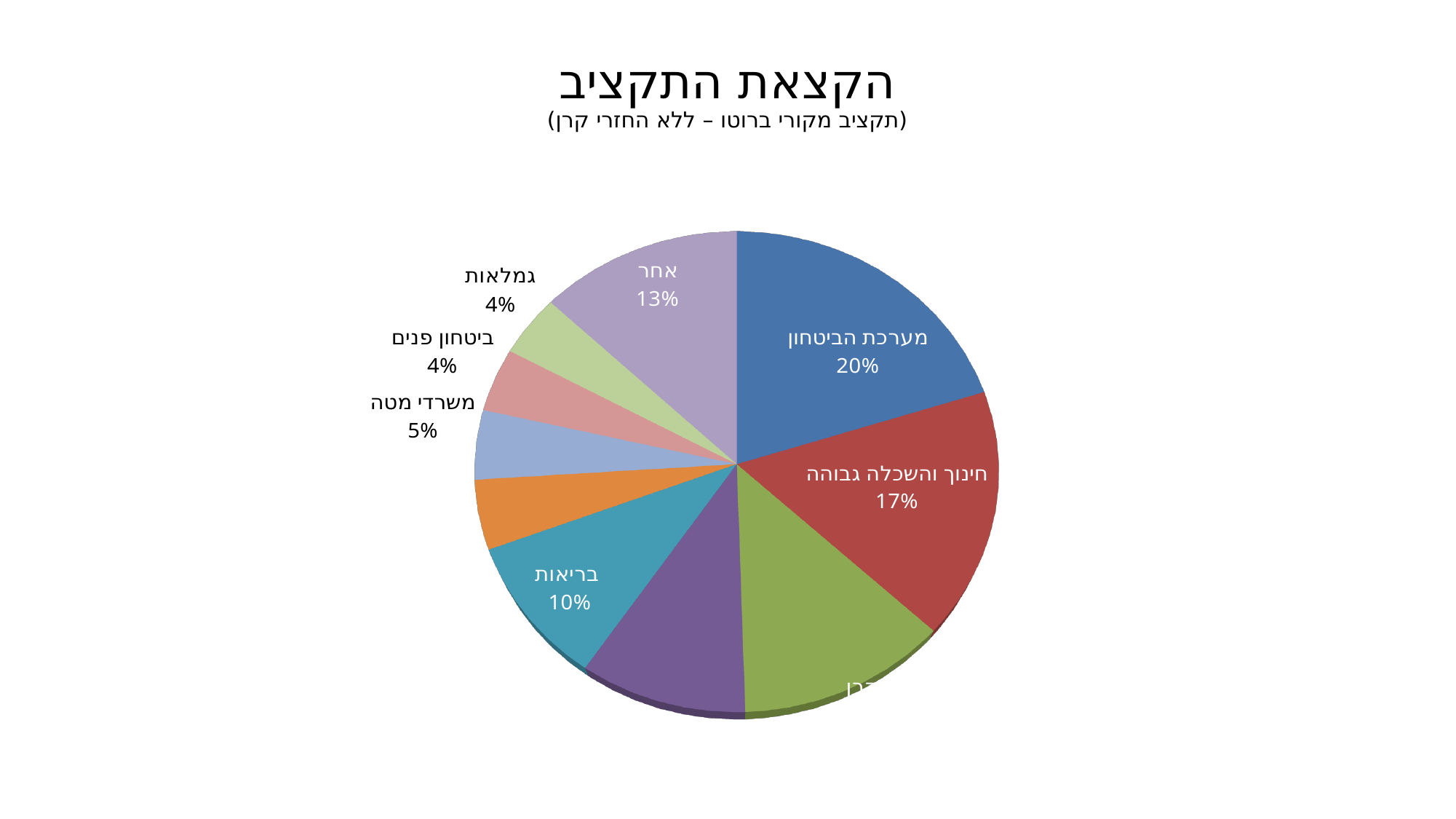
What kind of chart is shown on the slide? pie chart How many slices does the pie chart have? 10 Which is larger, the share for אחר or the share for בריאות? אחר What is the value shown for ביטחון פנים? 4% What is the title of the chart? הקצאת התקציב What share of the pie does חינוך והשכלה גבוהה take? 17% Which category has the largest slice of the pie? מערכת הביטחון What is the value shown for משרדי מטה? 5% What is the value shown for בריאות? 10% What is the difference between the shares of מערכת הביטחון and חינוך והשכלה גבוהה? 3% What share of the pie does מערכת הביטחון take? 20% What is the value shown for אחר? 13%